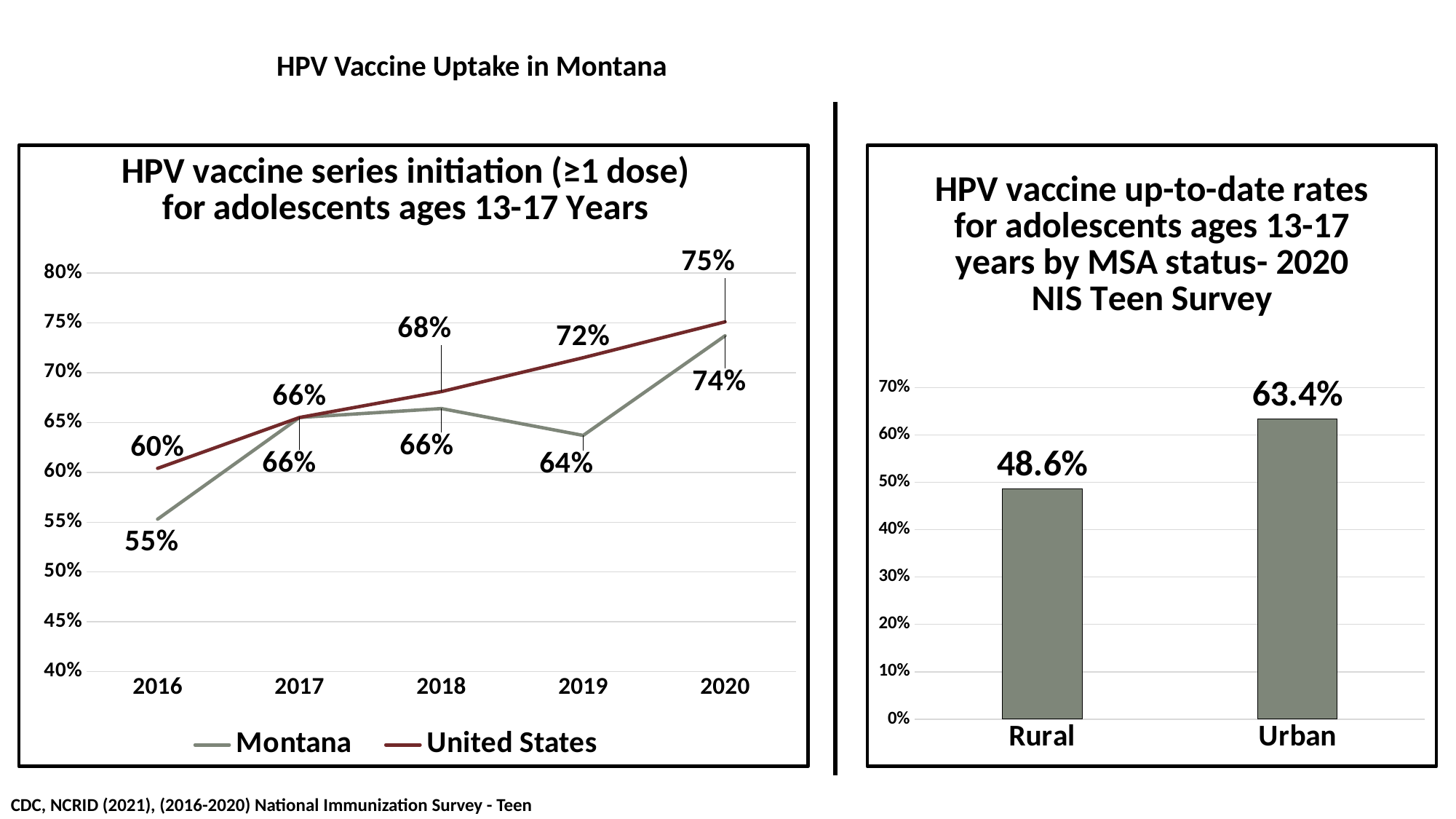
In the 'HPV vaccine up-to-date rates' bar chart, what is the value for Rural? 48.6% What kind of chart is the 'HPV vaccine up-to-date rates' chart on the right? bar chart In the 'HPV vaccine series initiation' line chart, how many series does the legend list? 2 In the 'HPV vaccine series initiation' line chart, what is the difference between the United States and Montana values in 2019? 8% In the 'HPV vaccine series initiation' line chart, what was Montana's value in 2020? 74% In the 'HPV vaccine series initiation' line chart, what was the United States value in 2019? 72% In the 'HPV vaccine series initiation' line chart, what was Montana's value in 2016? 55% In the 'HPV vaccine series initiation' line chart, which series had the higher value in 2016, Montana or United States? United States In the 'HPV vaccine up-to-date rates' bar chart, which category has the highest value? Urban In the 'HPV vaccine series initiation' line chart, does the United States series rise or fall from 2016 to 2020? rise In the 'HPV vaccine up-to-date rates' bar chart, what is the difference between the Urban and Rural values? 14.8% In the 'HPV vaccine series initiation' line chart, how many years are shown on the x axis? 5